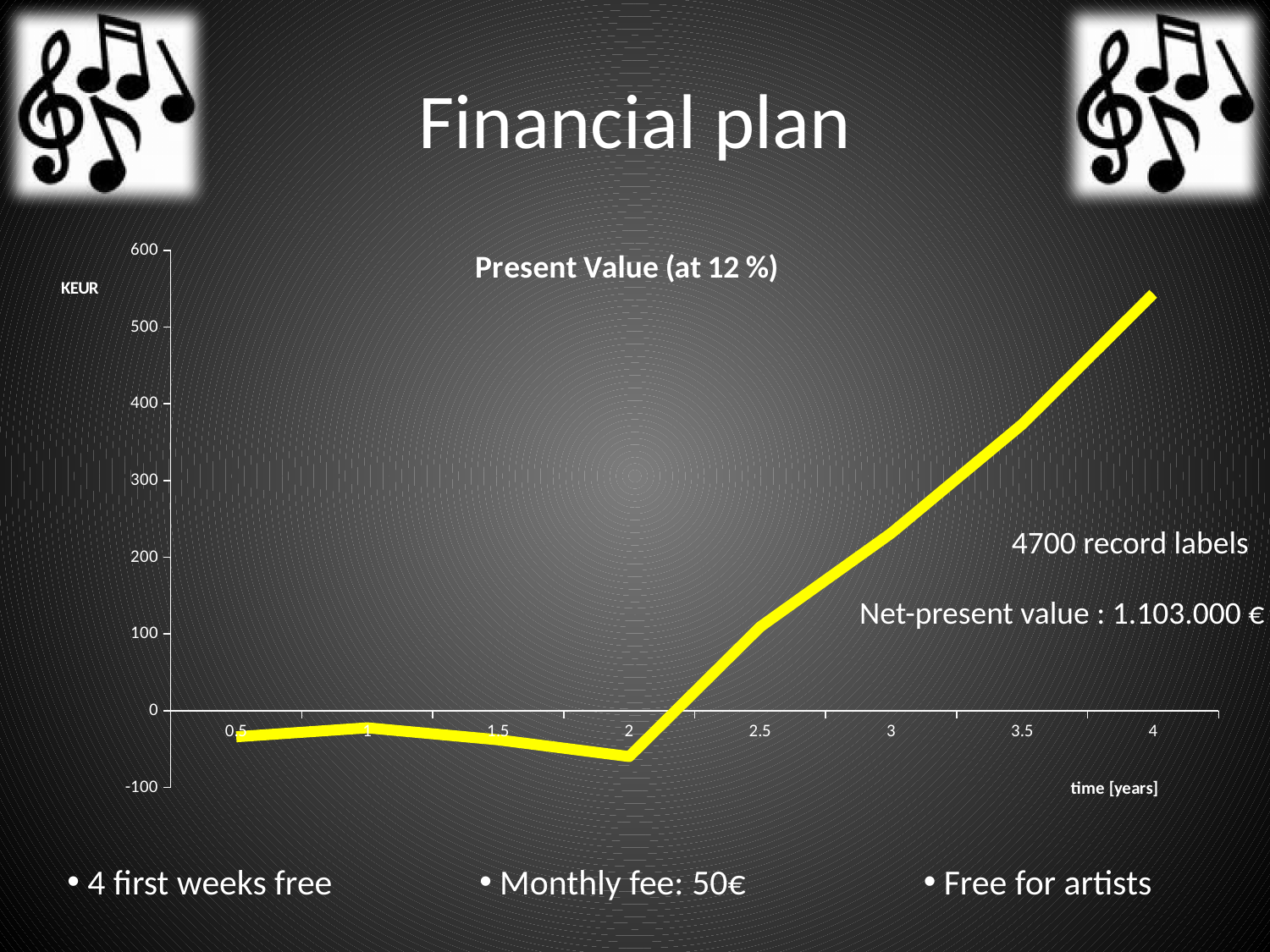
What is the label of the x axis of the chart? time [years] What kind of chart is shown on the slide? line chart How many data points are plotted on the line? 8 Which has the larger value, time 3.5 or time 2.5? 3.5 Does the line rise or fall between time 2 and time 4? rise Is the value at time 3 greater or less than 200? greater What is the title of the chart? Present Value (at 12 %) Is the value at time 2 greater or less than 0? less At which time [years] does the line reach its lowest value? 2 At which time [years] does the line reach its highest value? 4 Is the value at time 2.5 greater or less than 200? less